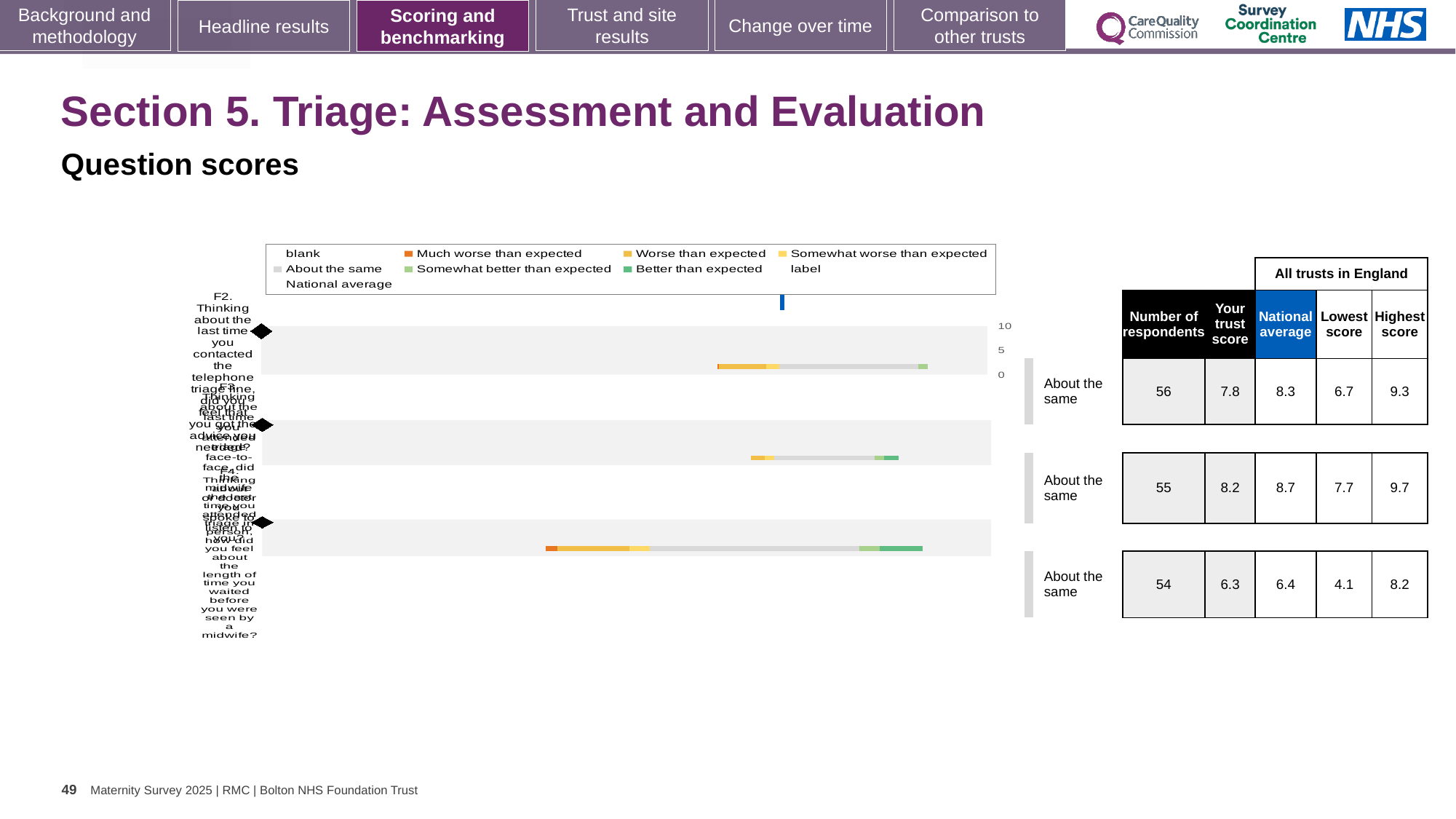
In the chart legend, which colour represents 'Much worse than expected'? orange In the chart legend, which colour represents 'Better than expected'? green Which of the three question rows has the lowest 'Lowest score' across all trusts in England? the bottom row (F4), 4.1 What kind of chart is shown on the slide? bar chart What is the highest score across all trusts in England for the bottom bar (F4)? 8.2 Which of the three question rows has the highest 'Your trust score'? the middle row (F3), 8.2 For the bottom row (F4), what is the difference between the highest score and the lowest score across all trusts in England? 4.1 What is the number of respondents for the bottom bar (F4) in the table beside the chart? 54 What is the national average for the middle bar (F3) in the table beside the chart? 8.7 What is the 'Your trust score' for the top bar (F2) in the table beside the chart? 7.8 How many question bars are plotted in the chart? 3 For the top row (F2), which is larger: the trust score or the national average? the national average